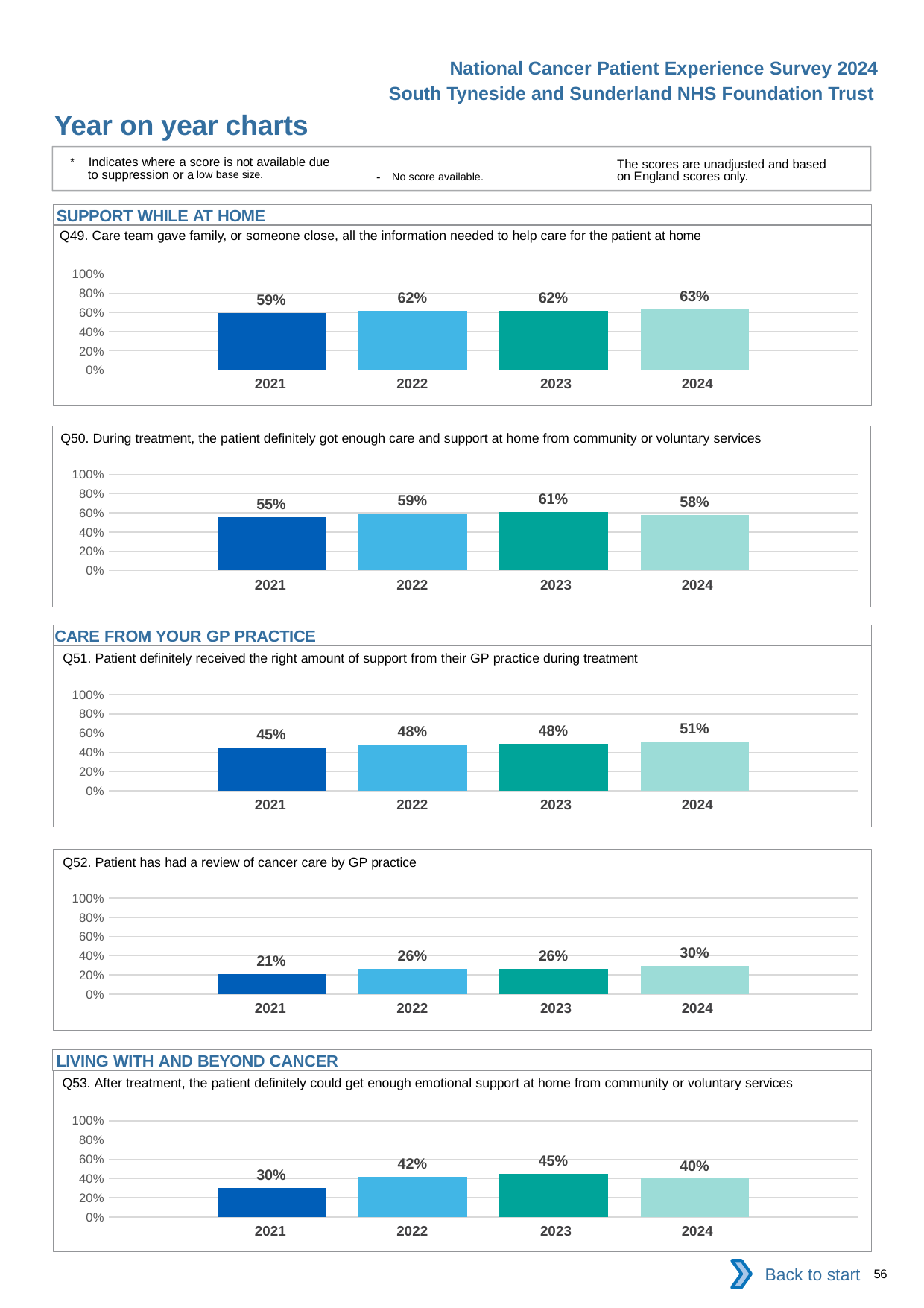
In the Q53 chart, is the value for 2023 larger or smaller than the value for 2024? larger In the Q49 chart, what is the value for 2024? 63% In the Q52 chart, which year has the lowest value? 2021 In the Q53 chart, what is the value for 2022? 42% How many years are shown in the Q50 chart? 4 Which section heading appears above the Q53 chart? LIVING WITH AND BEYOND CANCER In the Q51 chart, what is the difference between the 2024 and 2021 values? 6% In the Q50 chart, what is the difference between the 2023 and 2021 values? 6% In the Q52 chart, is the value for 2024 greater or less than 40%? less In the Q51 chart, do the values generally rise or fall from 2021 to 2024? rise What kind of chart is the Q51 chart? bar chart In the Q50 chart, which year has the highest value? 2023